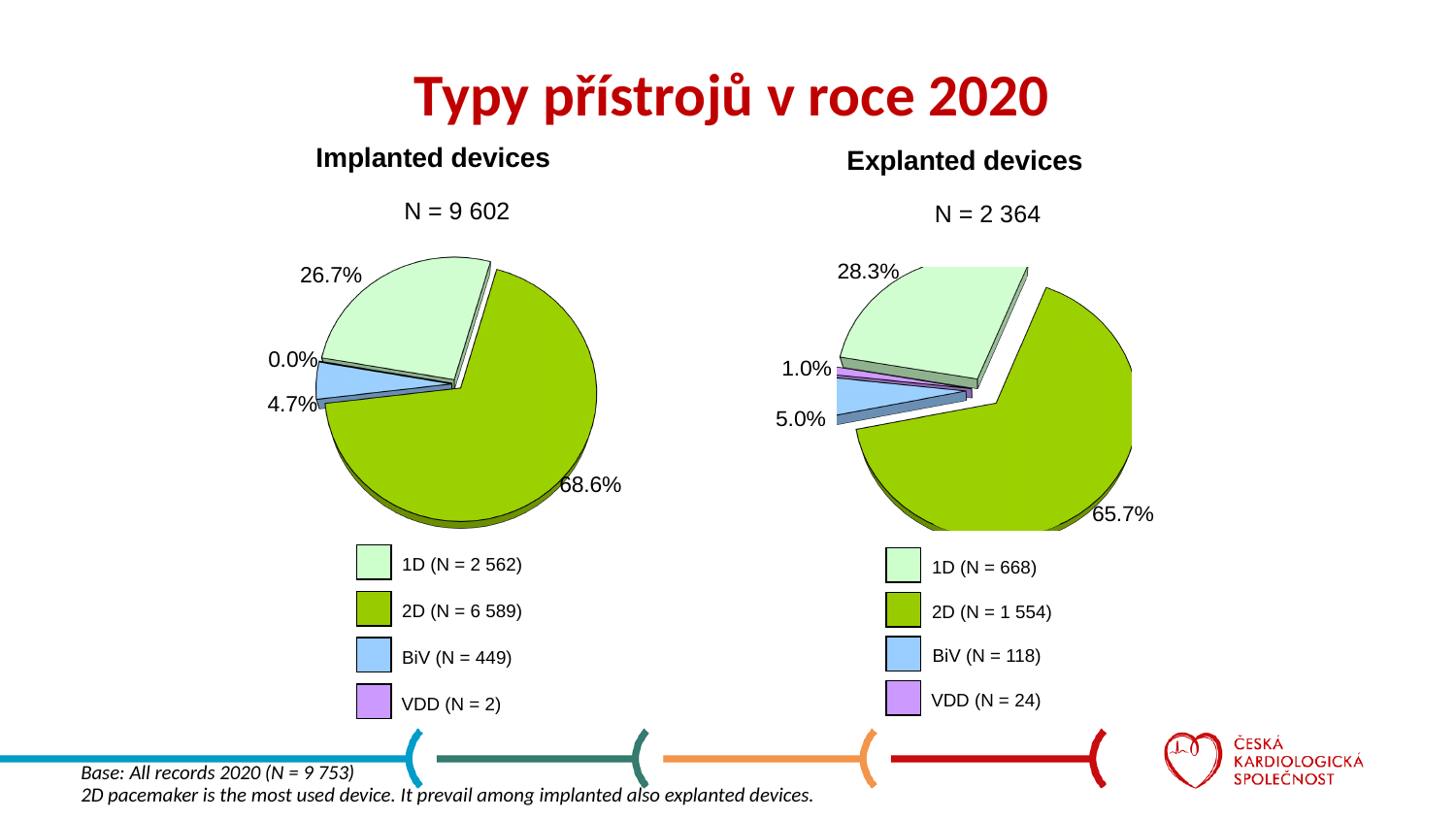
What kind of chart is used for Implanted devices? Pie chart In the Explanted devices pie chart, what share does 1D have? 28.3% What is the total N shown for the Explanted devices chart? N = 2 364 How many slices does the Explanted devices pie chart have? 4 In the Implanted devices pie chart, what share does 2D have? 68.6% In the Explanted devices pie chart, what share does VDD have? 1.0% In the Explanted devices pie chart, which device type has the smallest share? VDD In the Implanted devices pie chart, what is the count for BiV shown in the legend? 449 In the Implanted devices pie chart, what is the difference in percentage points between the 2D and 1D shares? 41.9 In the Explanted devices pie chart, which is larger: the share for BiV or the share for VDD? BiV In the Implanted devices chart, what colour is the 2D slice? Green In the Implanted devices pie chart, which device type has the largest share? 2D